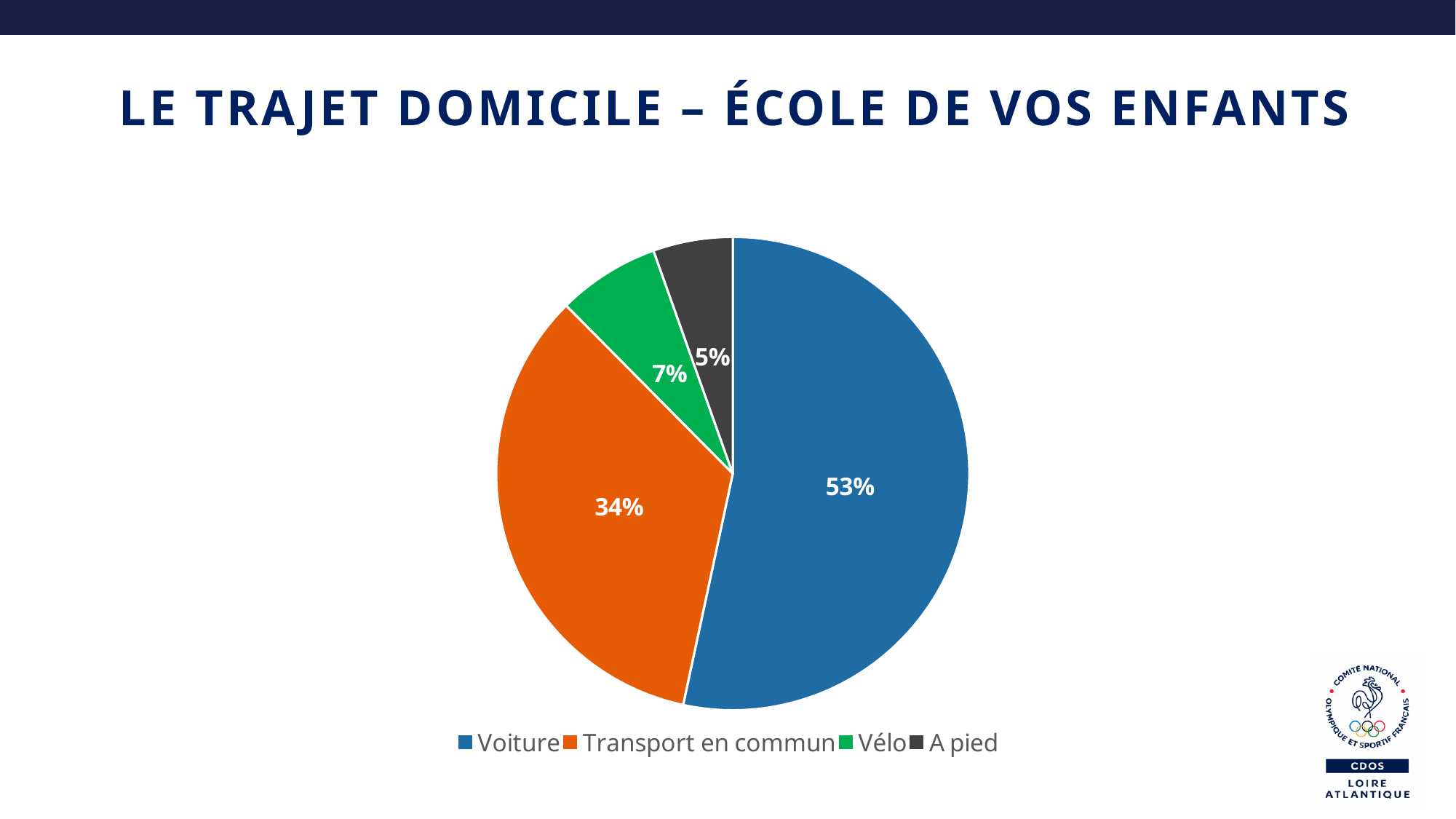
What is the title of the slide? LE TRAJET DOMICILE – ÉCOLE DE VOS ENFANTS What share of the pie does A pied represent? 5% What share of the pie does Transport en commun represent? 34% What is the difference in percentage points between Voiture and Transport en commun? 19 What share of the pie does Vélo represent? 7% Which category has the smallest slice of the pie? A pied What colour is the slice for Transport en commun? Orange How many categories are shown in the pie chart? 4 Which category has the largest slice of the pie? Voiture What kind of chart is shown on the slide? Pie chart What share of the pie does Voiture represent? 53% Which is larger, the share for Vélo or the share for A pied? Vélo